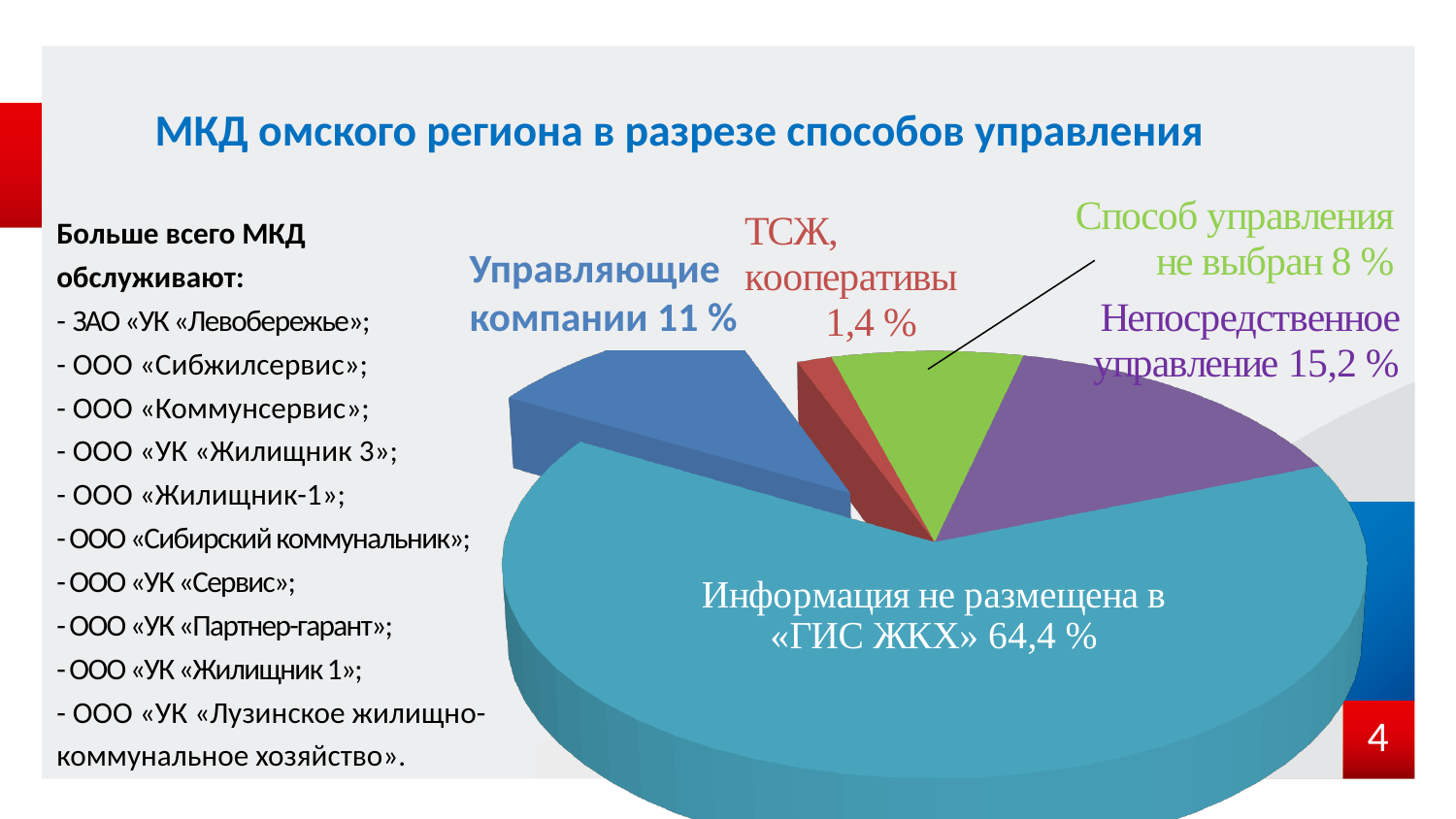
Which is larger: the share for «Непосредственное управление» or the share for «Управляющие компании»? Непосредственное управление What is the title of the slide containing the pie chart? МКД омского региона в разрезе способов управления Which category has the smallest slice of the pie? ТСЖ, кооперативы What kind of chart is shown on the slide? Pie chart Which category has the largest slice of the pie? Информация не размещена в «ГИС ЖКХ» What is the share of the slice labelled «ТСЖ, кооперативы»? 1,4 % What is the share of the slice labelled «Непосредственное управление»? 15,2 % What is the share of the slice labelled «Управляющие компании»? 11 % What is the difference between the share for «Информация не размещена в «ГИС ЖКХ»» and the share for «Непосредственное управление»? 49,2 % How many slices does the pie chart have? 5 What is the share of the slice labelled «Информация не размещена в «ГИС ЖКХ»»? 64,4 % What is the share of the slice labelled «Способ управления не выбран»? 8 %